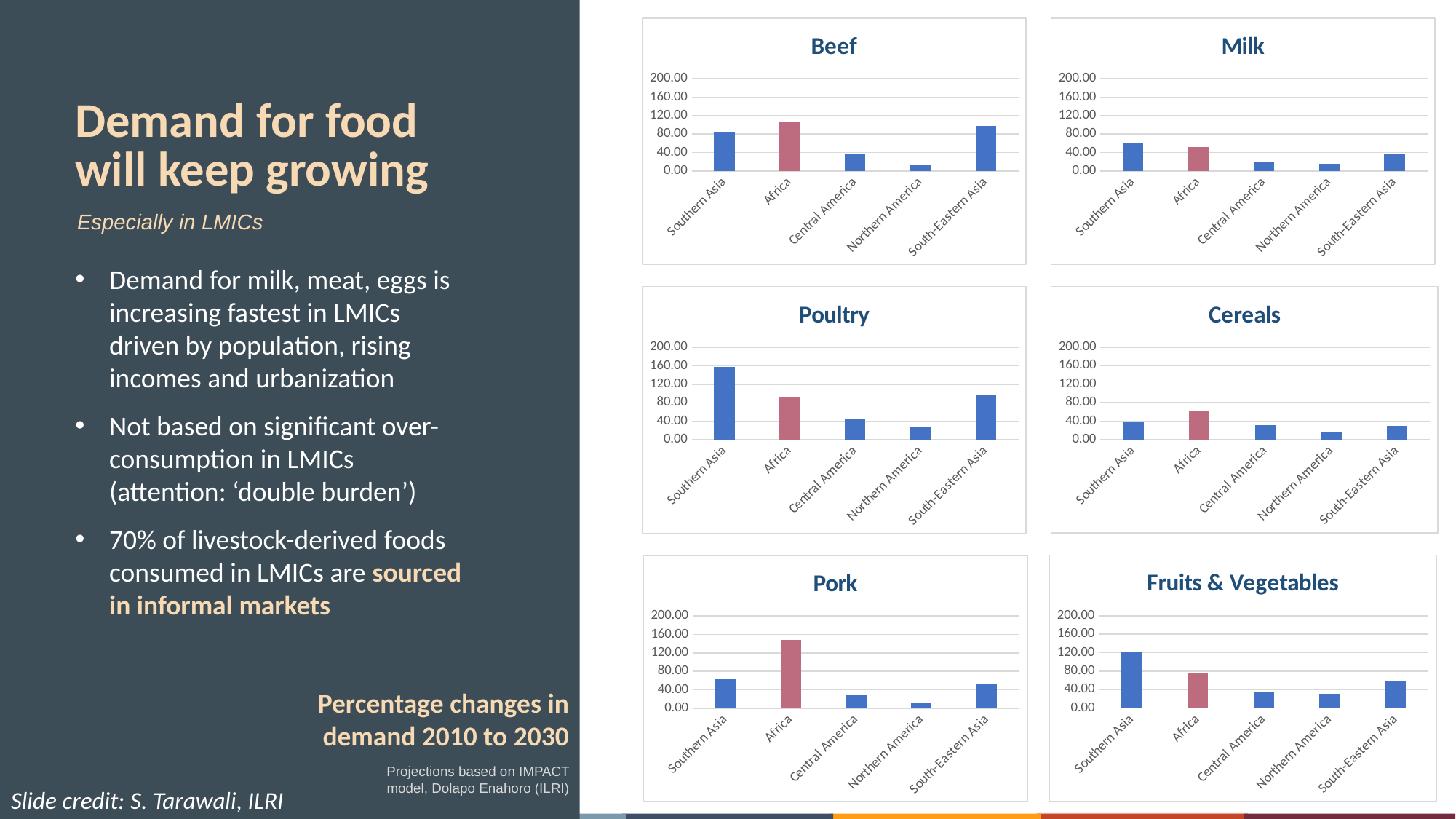
On the Cereals chart, which region has the highest value? Africa How many regions are shown on the Poultry chart? 5 On the Poultry chart, is the value for Southern Asia greater or less than 120? greater On the Beef chart, which region has the lowest value? Northern America On the Beef chart, which region has the highest value? Africa On the Beef chart, is the value for Northern America greater or less than 40? less On the Pork chart, is the value for Africa greater or less than 120? greater What kind of chart is the Beef chart? bar chart On the Milk chart, which region has the highest value? Southern Asia On the Fruits & Vegetables chart, which is larger, the value for Southern Asia or the value for Africa? Southern Asia